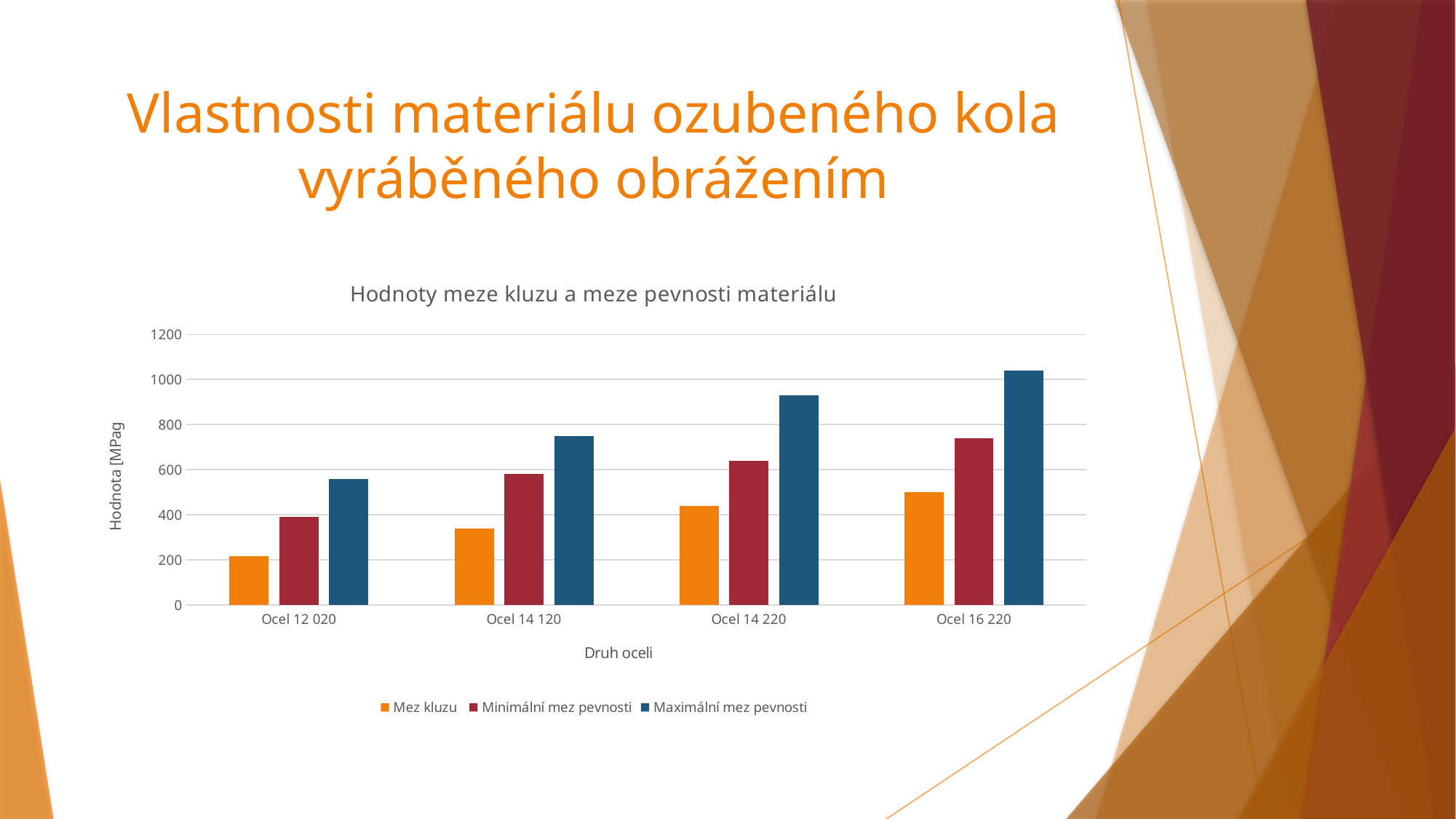
Is the Maximální mez pevnosti value for Ocel 16 220 greater or less than 1000? greater What is the title of the chart? Hodnoty meze kluzu a meze pevnosti materiálu Do the Maximální mez pevnosti values rise or fall from Ocel 12 020 to Ocel 16 220? rise Is the Minimální mez pevnosti value for Ocel 16 220 greater or less than 800? less Is the Maximální mez pevnosti value for Ocel 14 220 greater or less than 800? greater Which steel type has the lowest Mez kluzu? Ocel 12 020 How many steel types (categories) are shown on the x axis? 4 Which steel type has the highest Maximální mez pevnosti? Ocel 16 220 Which is larger: the Mez kluzu for Ocel 14 220 or for Ocel 14 120? Ocel 14 220 How many series does the legend list? 3 What type of chart is shown on the slide? Bar chart